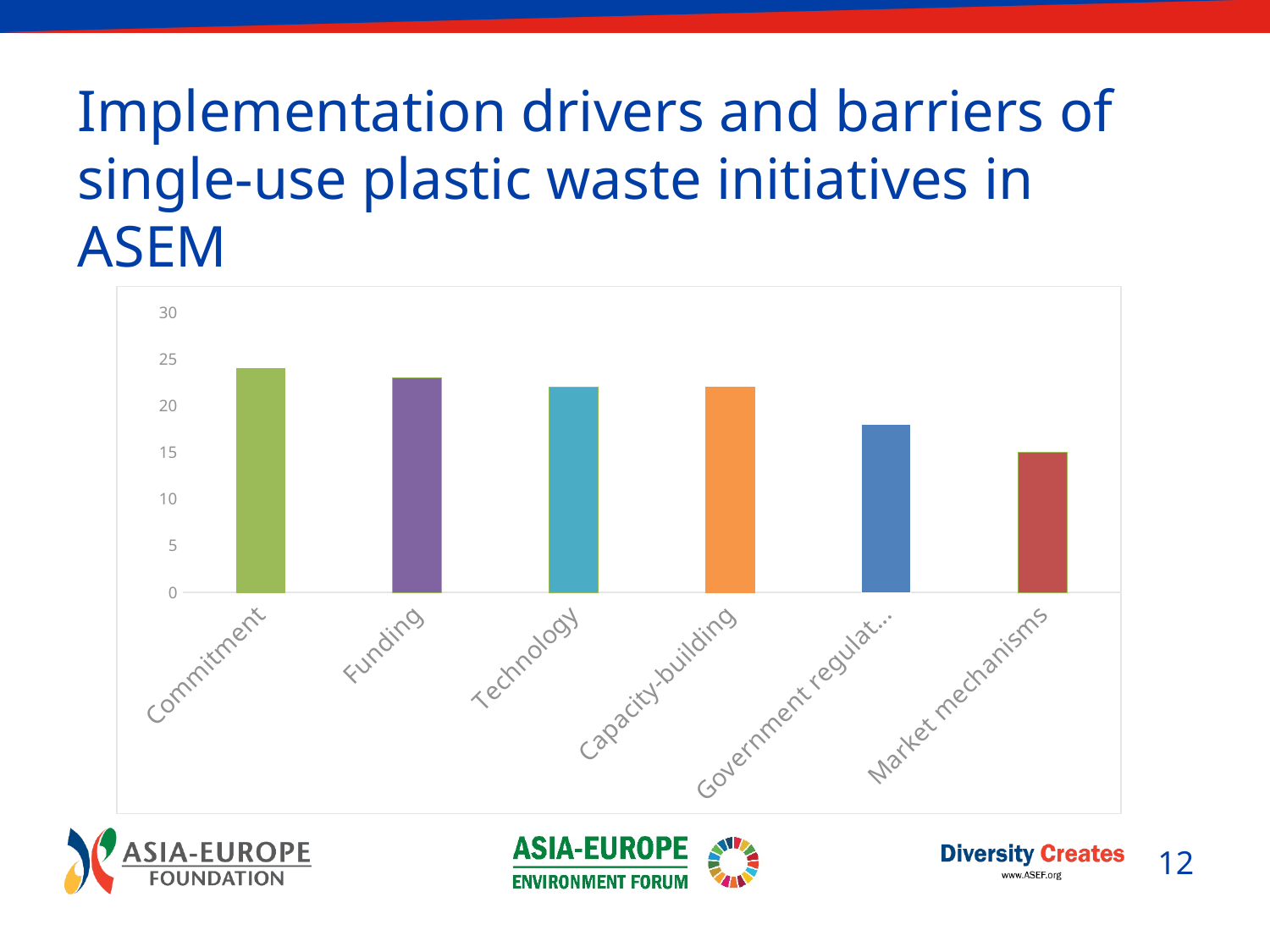
Is the value for Market mechanisms greater or less than 20? less Which category has the highest bar in the chart? Commitment What kind of chart is shown on the slide? bar chart Is the value for Commitment greater or less than 20? greater Is the value for Funding greater or less than 25? less Do the bar values rise or fall from left to right along the x axis? fall Which is larger, the value for Commitment or the value for Market mechanisms? Commitment What colour is the bar for Commitment? green How many categories are plotted in the chart? 6 Which is larger, the value for Funding or the value for Market mechanisms? Funding Which category has the lowest bar in the chart? Market mechanisms